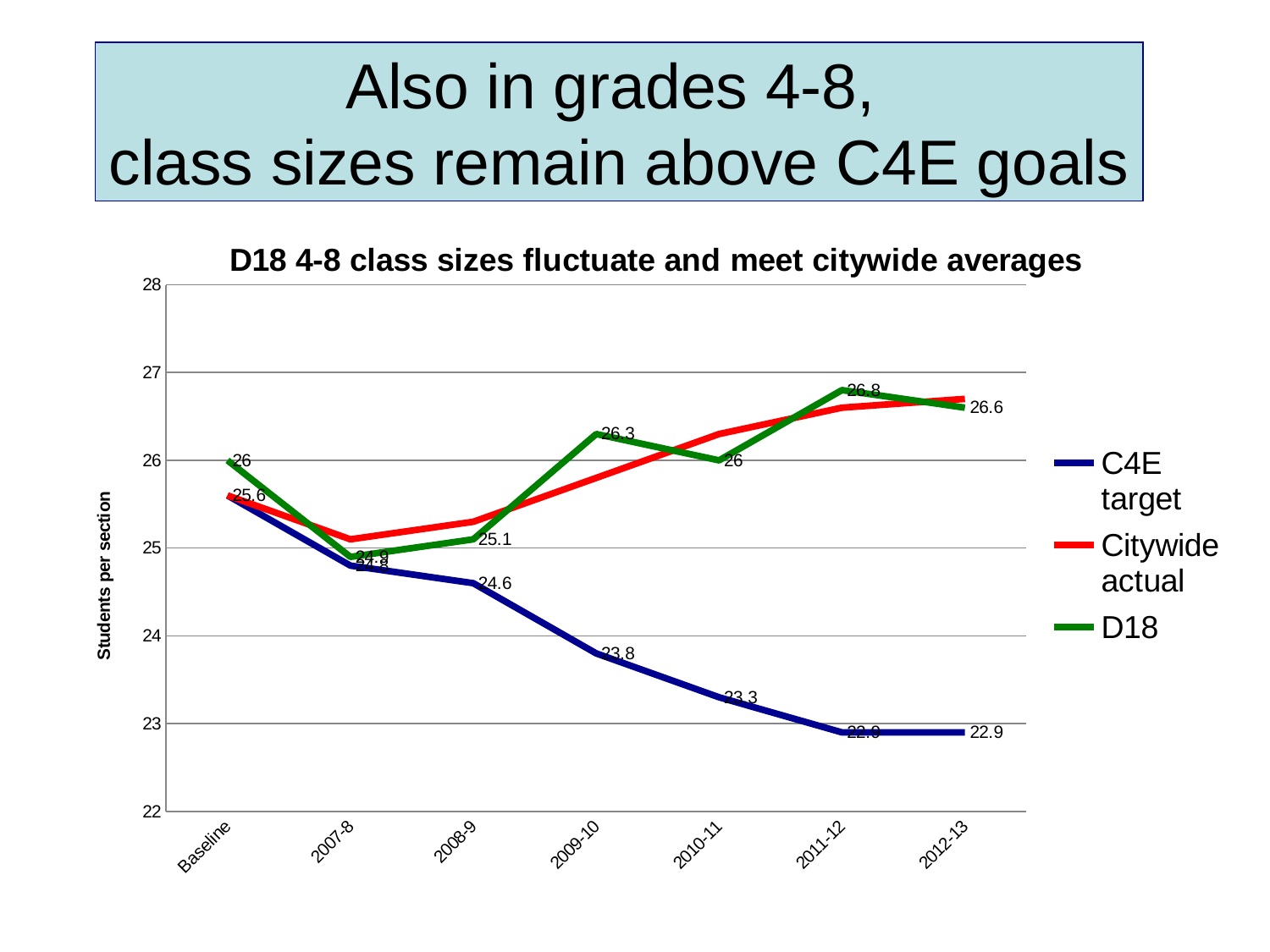
How many time periods are shown on the x axis? 7 What type of chart is shown on the slide? Line chart What is the D18 value for 2009-10? 26.3 What is the C4E target value for 2010-11? 23.3 What is the C4E target value for 2012-13? 22.9 Is the Citywide actual value for 2012-13 greater or less than 26? greater What is the difference between the D18 value and the C4E target value in 2009-10? 2.5 Does the C4E target series rise or fall from Baseline to 2012-13? Fall What is the D18 value for 2012-13? 26.6 In which period is the D18 value lowest? 2007-8 In which period is the D18 value highest? 2011-12 How many series does the legend list? 3